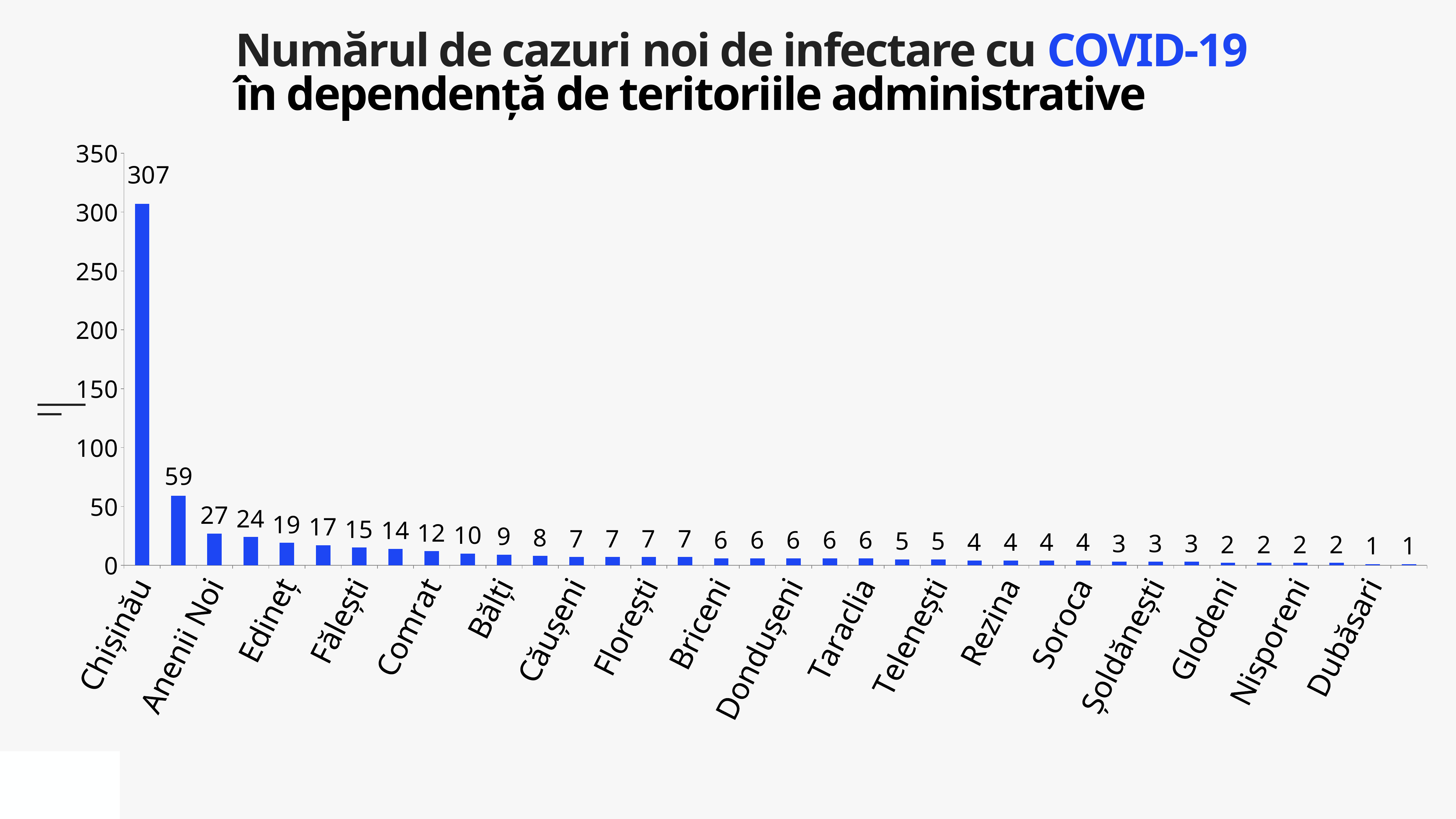
What colour are the bars in the chart? blue Is the value for Comrat greater or less than 50? less What is the difference between the number of new cases in Chișinău and in Dubăsari? 306 Which administrative territory has the highest number of new COVID-19 cases? Chișinău How many new COVID-19 cases are shown for Chișinău? 307 Which labelled administrative territory has the lowest number of new cases? Dubăsari Is the value for Chișinău greater or less than 300? greater What type of chart is shown on the slide? bar chart How many new cases are shown for Dubăsari? 1 Do the values rise or fall from left to right along the x axis? fall Is the value for Anenii Noi greater or less than 100? less Which has more new cases, Chișinău or Anenii Noi? Chișinău